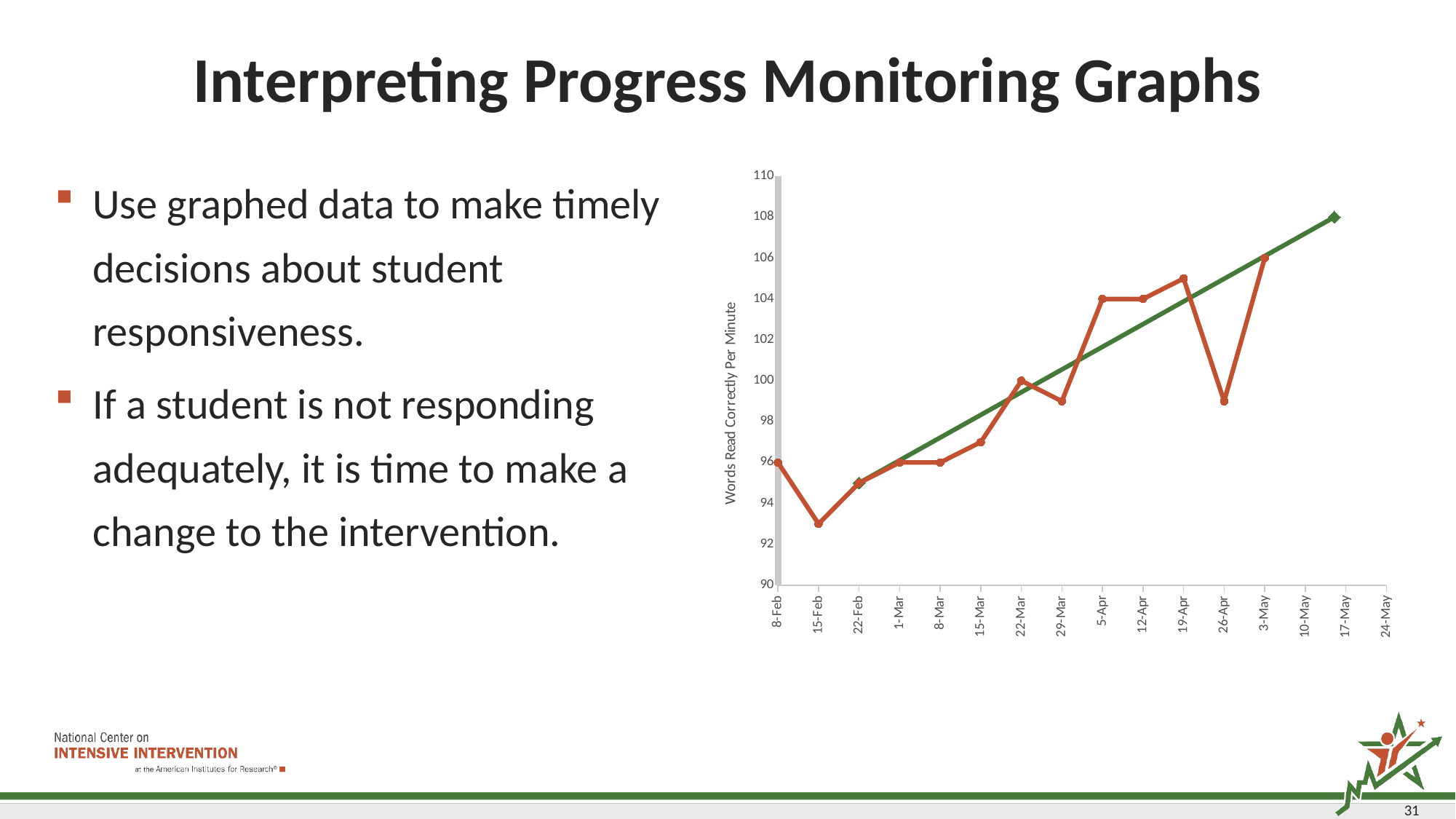
What value does the green goal line reach at 17-May? 108 Which date has the higher value on the orange line, 22-Mar or 29-Mar? 22-Mar Is the value for 19-Apr greater or less than 104? greater What is the label on the vertical axis of the chart? Words Read Correctly Per Minute On which date does the orange data line reach its highest value? 3-May On which date does the orange data line reach its lowest value? 15-Feb Is the value for 15-Feb greater or less than 94? less Is the value for 26-Apr greater or less than 100? less How many dates are labelled along the x axis of the chart? 16 What kind of chart is shown on the slide? line chart Overall, do the values on the orange data line rise or fall from 8-Feb to 3-May? rise Which date has the higher value on the orange line, 5-Apr or 26-Apr? 5-Apr